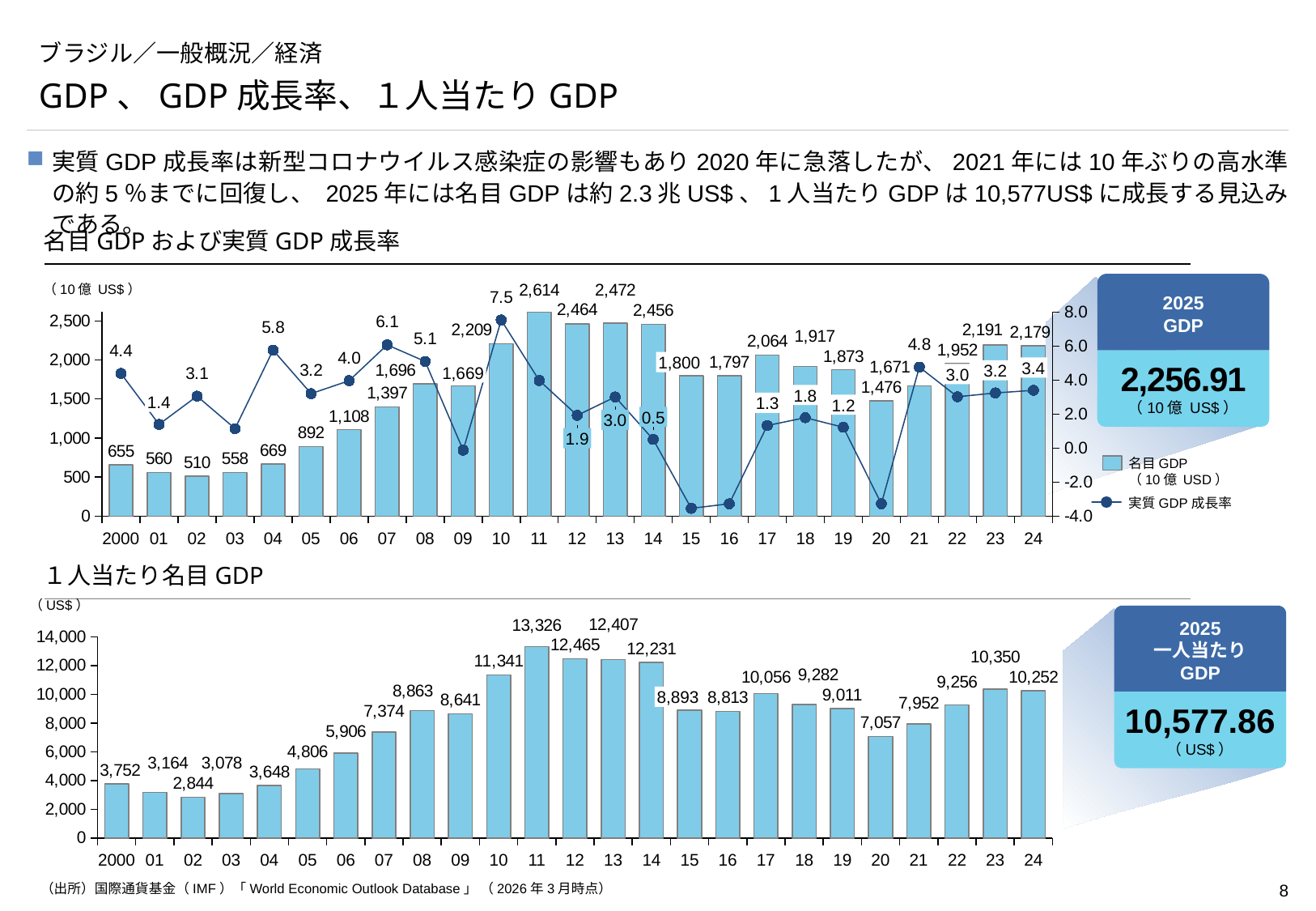
In the 名目GDPおよび実質GDP成長率 chart, which year has the lowest nominal GDP bar? 02 How many years are plotted on the x axis of the 1人当たり名目GDP chart? 25 What kind of chart is the 1人当たり名目GDP chart? bar chart In the 1人当たり名目GDP chart, which year has the highest value? 11 In the 名目GDPおよび実質GDP成長率 chart, what is the difference between the nominal GDP values for 23 and 24? 12 In the 1人当たり名目GDP chart, which is larger, the value for 17 or the value for 18? 17 How many series does the legend of the 名目GDPおよび実質GDP成長率 chart list? 2 In the 名目GDPおよび実質GDP成長率 chart, what is the real GDP growth rate for 2010? 7.5 In the 1人当たり名目GDP chart, what is the difference between the values for 11 and 2000? 9,574 In the 1人当たり名目GDP chart, what is the value for 2000? 3,752 In the 名目GDPおよび実質GDP成長率 chart, what is the nominal GDP value for 2011? 2,614 In the 名目GDPおよび実質GDP成長率 chart, is the real GDP growth rate for 15 greater or less than -2.0? less